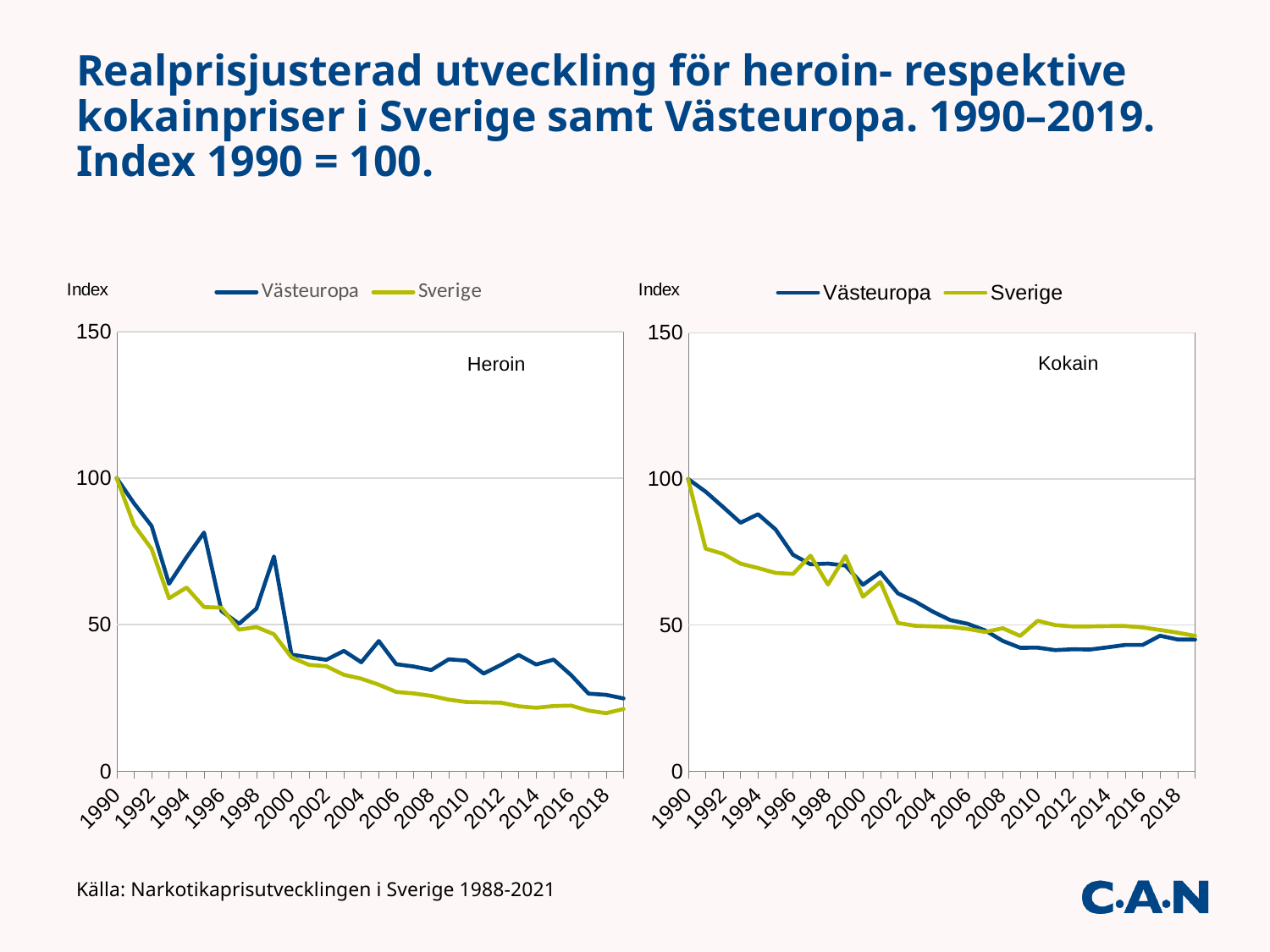
In the Kokain chart, is the value for Sverige in 1991 greater or less than 50? greater In the Kokain chart, what is the index value for Västeuropa in 1990? 100 In the Kokain chart, is the value for Västeuropa in 2012 greater or less than 50? less In the Heroin chart, is the value for Västeuropa in 1995 greater or less than 50? greater In the Kokain chart, which series has the higher value in 1993, Västeuropa or Sverige? Västeuropa In the Heroin chart, which series has the higher value in 2010, Västeuropa or Sverige? Västeuropa How many series does the legend of the Kokain chart list? 2 What kind of chart is the Heroin chart on the left? Line chart Which colour is used for the Sverige line in both charts? Green In the Heroin chart, do the values for Sverige generally rise or fall from 1990 to 2019? Fall In the Heroin chart, what is the index value for Sverige in 1990? 100